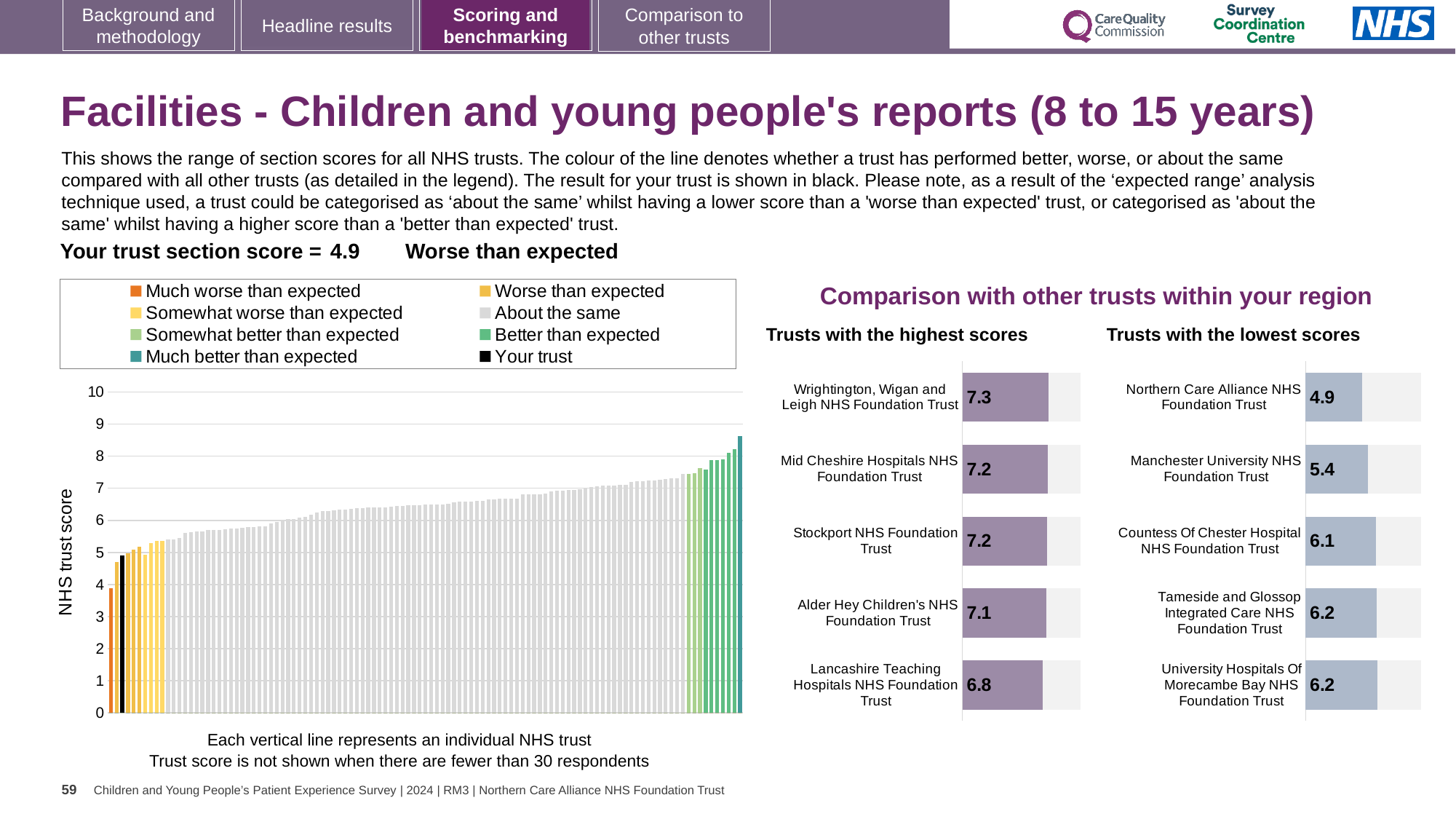
In the 'Trusts with the lowest scores' chart, which has the larger score: Countess Of Chester Hospital NHS Foundation Trust or Manchester University NHS Foundation Trust? Countess Of Chester Hospital NHS Foundation Trust How many entries does the legend of the main chart on the left list? 8 In the 'Trusts with the lowest scores' chart, which trust has the lowest score? Northern Care Alliance NHS Foundation Trust How many trusts are listed in the 'Trusts with the lowest scores' chart? 5 In the 'Trusts with the highest scores' chart, which trust has the highest score? Wrightington, Wigan and Leigh NHS Foundation Trust In the 'Trusts with the highest scores' chart, what is the difference between the scores of Wrightington, Wigan and Leigh NHS Foundation Trust and Lancashire Teaching Hospitals NHS Foundation Trust? 0.5 In the 'Trusts with the highest scores' chart, what is the score for Wrightington, Wigan and Leigh NHS Foundation Trust? 7.3 In the main chart on the left, is the value of the tallest bar greater or less than 8? greater In the 'Trusts with the highest scores' chart, what is the score for Lancashire Teaching Hospitals NHS Foundation Trust? 6.8 In the main chart on the left, what is the section score for your trust? 4.9 In the 'Trusts with the lowest scores' chart, what is the score for Manchester University NHS Foundation Trust? 5.4 In the main chart on the left, do the bar values rise or fall from left to right? rise